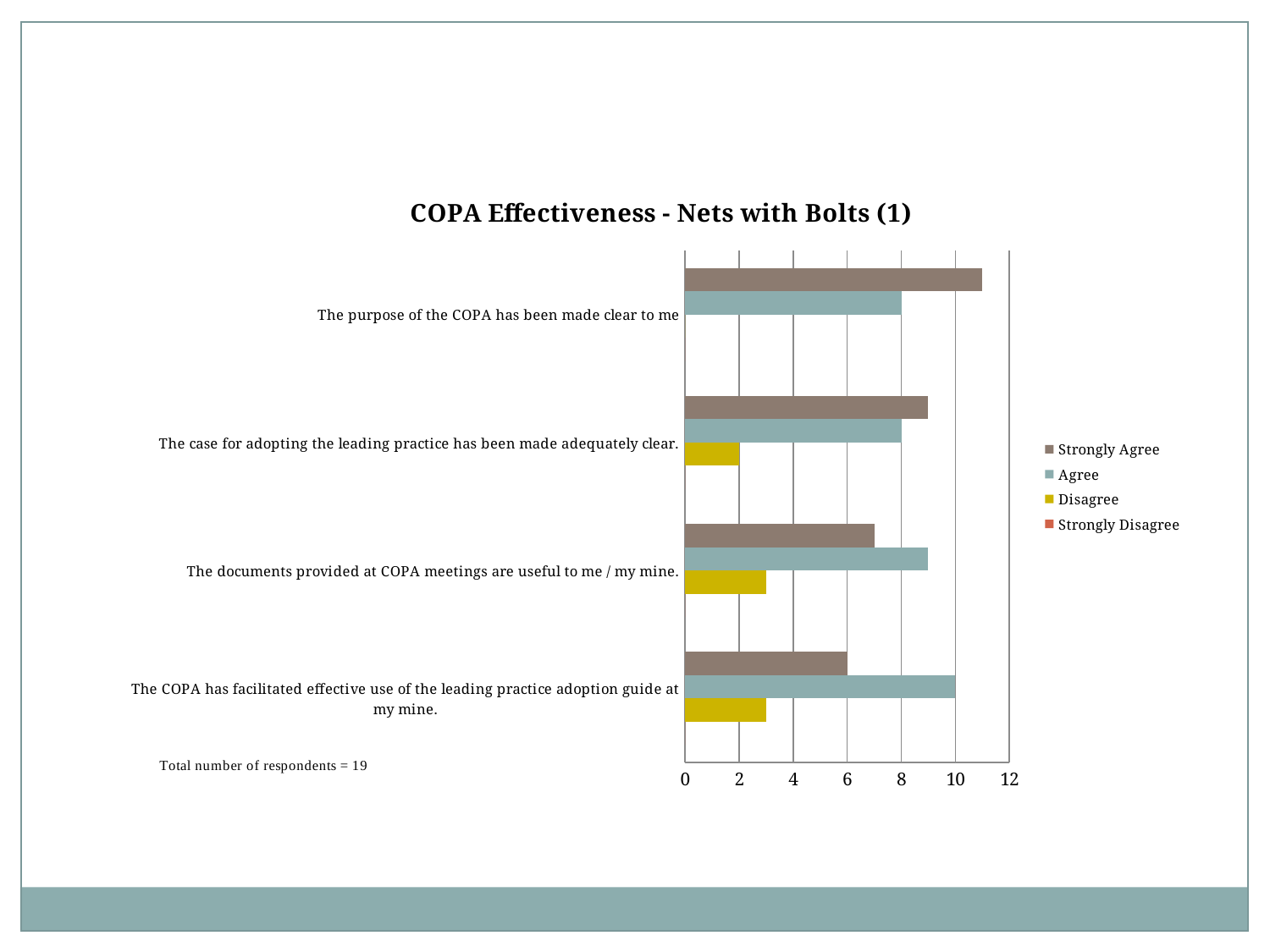
Is the Strongly Agree value for 'The purpose of the COPA has been made clear to me' greater or less than 10? greater What is the Agree value for 'The COPA has facilitated effective use of the leading practice adoption guide at my mine.'? 10 What kind of chart is shown on the slide? Bar chart Is the Strongly Agree value for 'The documents provided at COPA meetings are useful to me / my mine.' greater or less than 8? less What is the Disagree value for 'The case for adopting the leading practice has been made adequately clear.'? 2 Which statement has the highest Strongly Agree value? The purpose of the COPA has been made clear to me For 'The COPA has facilitated effective use of the leading practice adoption guide at my mine.', what is the difference between the Agree and Strongly Agree values? 4 For 'The documents provided at COPA meetings are useful to me / my mine.', which is larger: Agree or Strongly Agree? Agree How many series does the legend list? 4 What is the Agree value for 'The purpose of the COPA has been made clear to me'? 8 How many statements (categories) are plotted on the chart? 4 What is the Strongly Agree value for 'The COPA has facilitated effective use of the leading practice adoption guide at my mine.'? 6